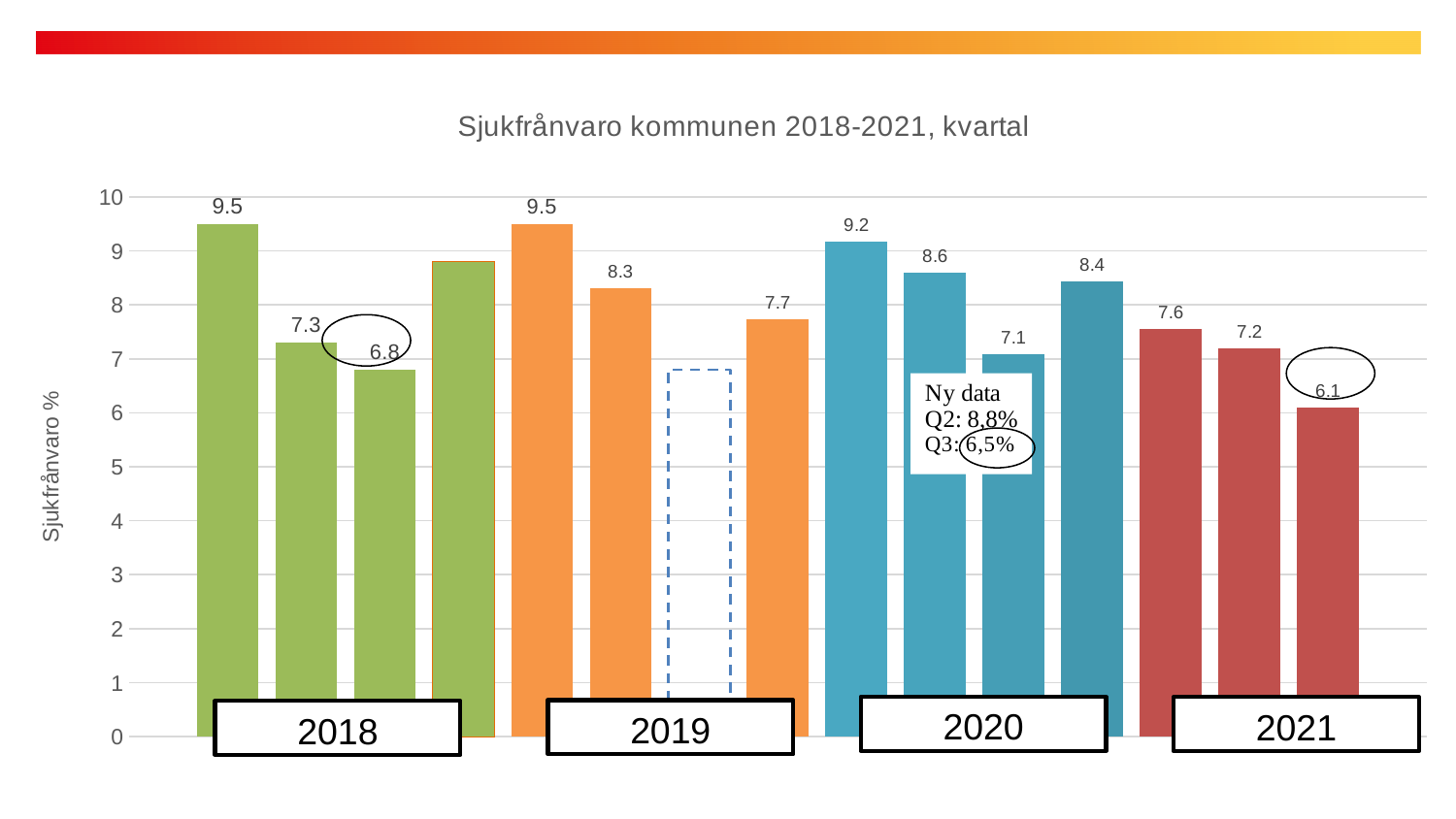
What is the title of the chart? Sjukfrånvaro kommunen 2018-2021, kvartal What kind of chart is shown on the slide? bar chart How many year groups are shown on the x axis? 4 What is the value of the first bar in the 2020 group? 9.2 What is the label of the vertical axis? Sjukfrånvaro % What is the value of the first bar in the 2018 group? 9.5 Do the values in the 2021 group rise or fall from the first bar to the last? fall What is the lowest labelled value in the chart? 6.1 What is the difference between the first bar (9.2) and the third bar (7.1) in the 2020 group? 2.1 What is the value of the last bar in the 2021 group? 6.1 Which is larger: the second bar of 2019 or the second bar of 2020? the second bar of 2020 Is the value of the fourth (unlabelled) bar in the 2018 group greater or less than 8? greater